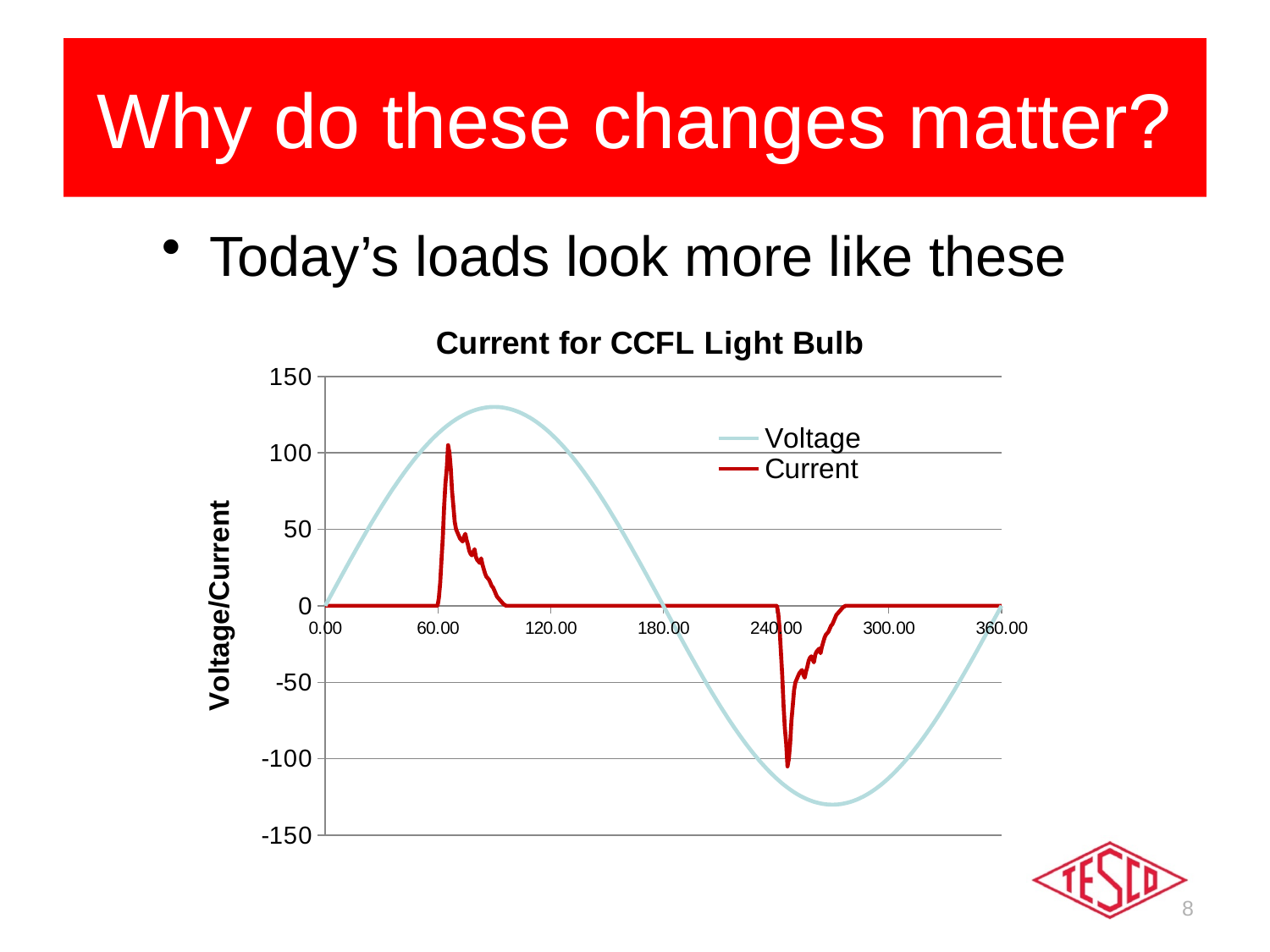
Is the peak positive value of the Current series greater or less than 50? greater What kind of chart is shown on the slide? line chart Is the peak value of the Voltage series greater or less than 150? less Which series reaches the higher peak value, Voltage or Current? Voltage How many series does the chart's legend list? 2 Does the Voltage series rise or fall between 0.00 and 60.00 on the x axis? rise Does the Voltage series rise or fall between 120.00 and 180.00 on the x axis? fall Is the minimum value of the Voltage series greater or less than -100? less What are the two series named in the chart's legend? Voltage and Current What is the title of the chart? Current for CCFL Light Bulb